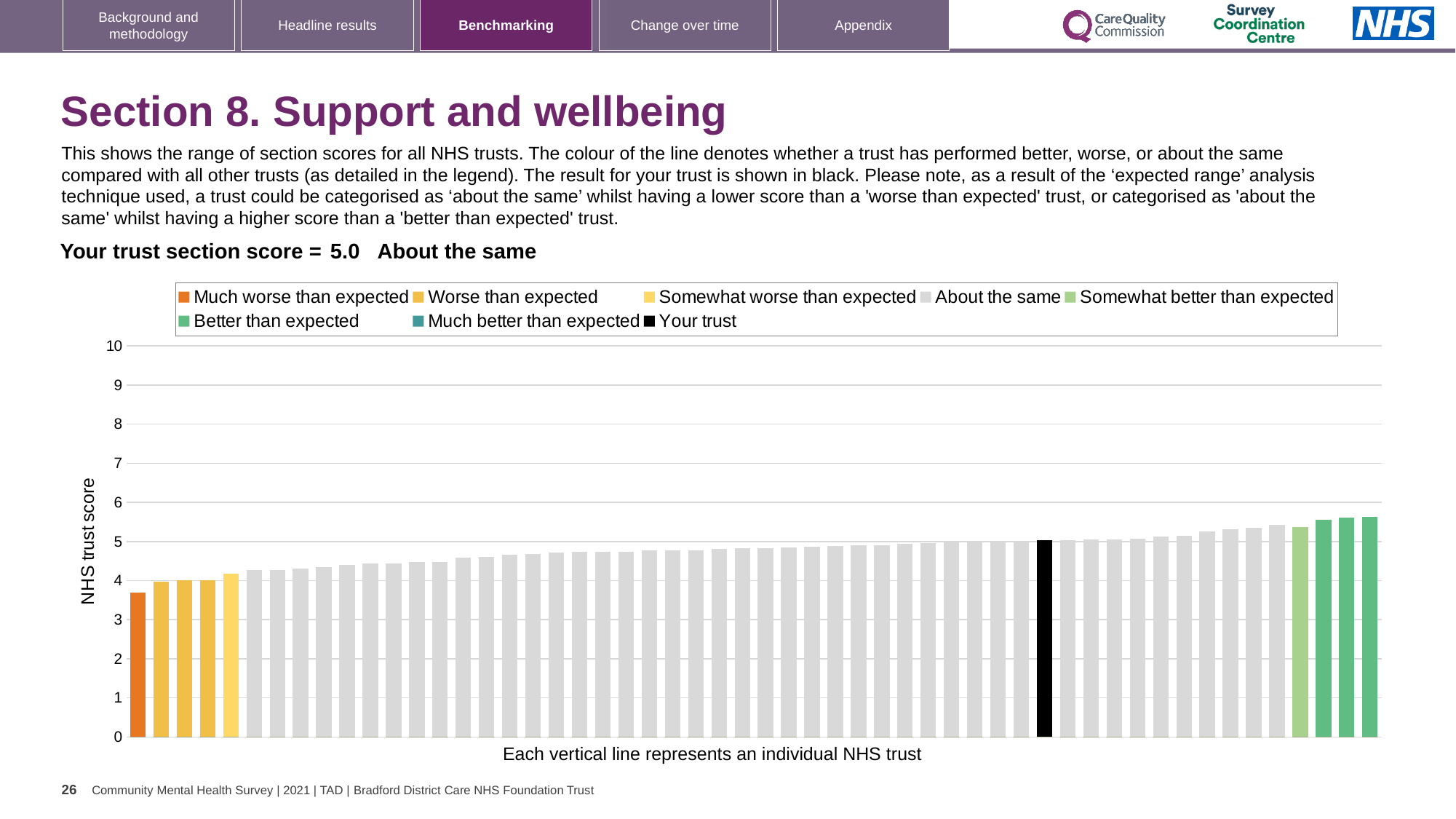
What colour is used for the bar representing your trust? black Do the bar values rise or fall moving from left to right along the x axis? rise Is the value for the highest bar on the chart greater or less than 5? greater How many entries does the chart legend list? 8 What is the label on the vertical axis of the chart? NHS trust score How many bars are coloured as 'Much worse than expected'? 1 Is the value for the highest bar on the chart greater or less than 6? less What kind of chart is shown on the slide? bar chart What is the section score for your trust shown on the slide? 5.0 How many bars are coloured as 'Better than expected'? 3 Is the value for the lowest bar (the 'Much worse than expected' trust) greater or less than 4? less Which benchmarking category is your trust placed in for Section 8? About the same